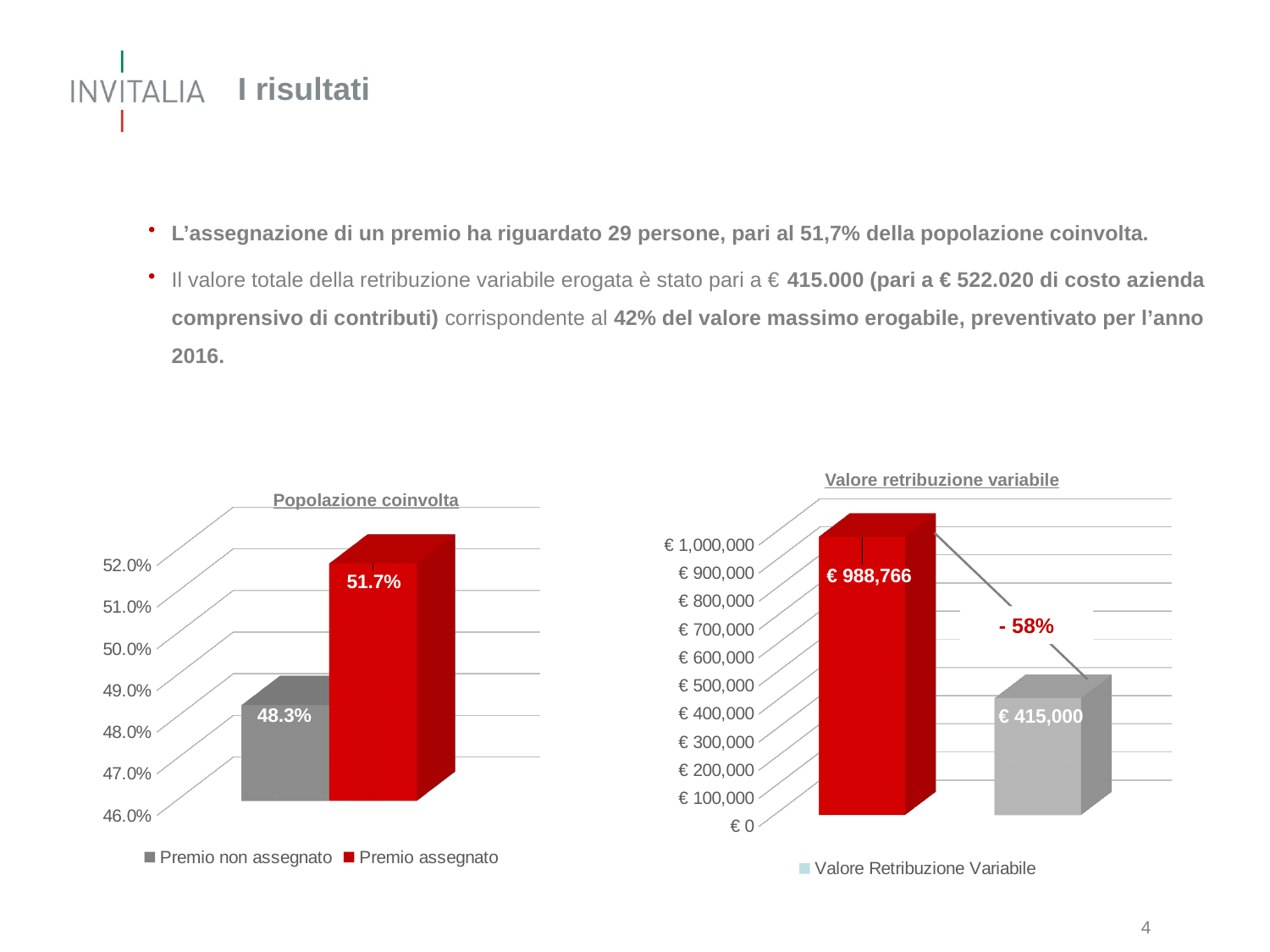
In the 'Valore retribuzione variabile' chart, what percentage change is annotated between the two bars? - 58% In the 'Popolazione coinvolta' chart, what is the value for Premio assegnato? 51.7% What kind of chart is 'Popolazione coinvolta'? Bar chart In the 'Valore retribuzione variabile' chart, is the value of the right bar greater or less than € 500,000? less In the 'Popolazione coinvolta' chart, which series has the higher value? Premio assegnato In the 'Valore retribuzione variabile' chart, what is the value of the right (grey) bar? € 415,000 In the 'Valore retribuzione variabile' chart, what is the difference between the left bar and the right bar? € 573,766 In the 'Popolazione coinvolta' chart, what is the difference between Premio assegnato and Premio non assegnato? 3.4% In the 'Popolazione coinvolta' chart, what is the value for Premio non assegnato? 48.3% How many series does the legend of the 'Popolazione coinvolta' chart list? 2 In the 'Valore retribuzione variabile' chart, what is the value of the left (red) bar? € 988,766 How many bars are plotted in the 'Valore retribuzione variabile' chart? 2